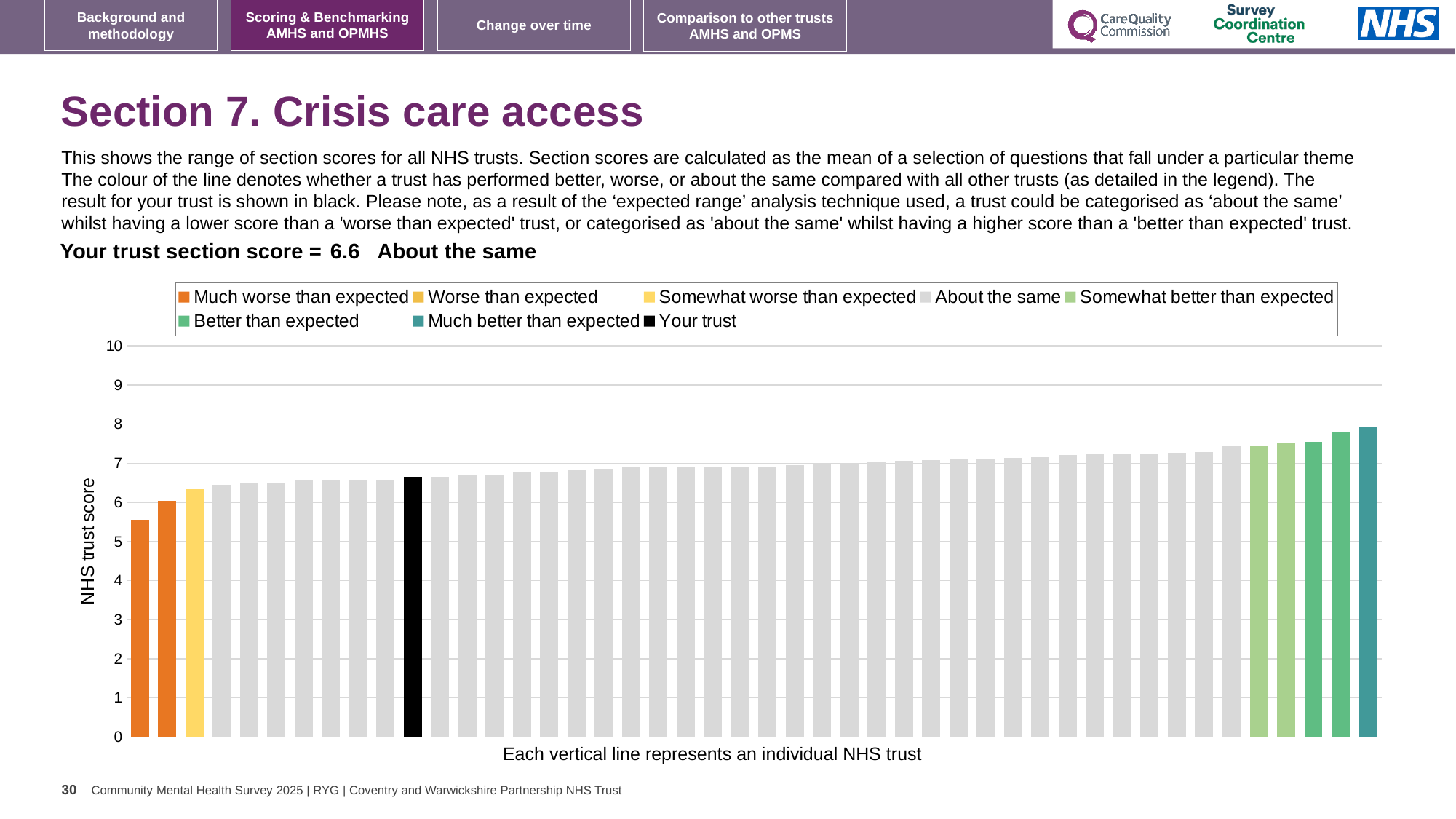
What kind of chart is shown on the slide? bar chart Do the bar values rise or fall from left to right along the x axis? rise How many entries does the chart legend list? 8 Is the value of the lowest bar on the chart greater or less than 6? less Which legend category does the shortest bar belong to? Much worse than expected What is the label on the vertical axis of the chart? NHS trust score Is the value of the black 'Your trust' bar greater or less than 5? greater How many bars are coloured as 'Much worse than expected'? 2 What is the section score for your trust shown on the chart? 6.6 Which legend category does the tallest bar belong to? Much better than expected How many bars are coloured as 'Much better than expected'? 1